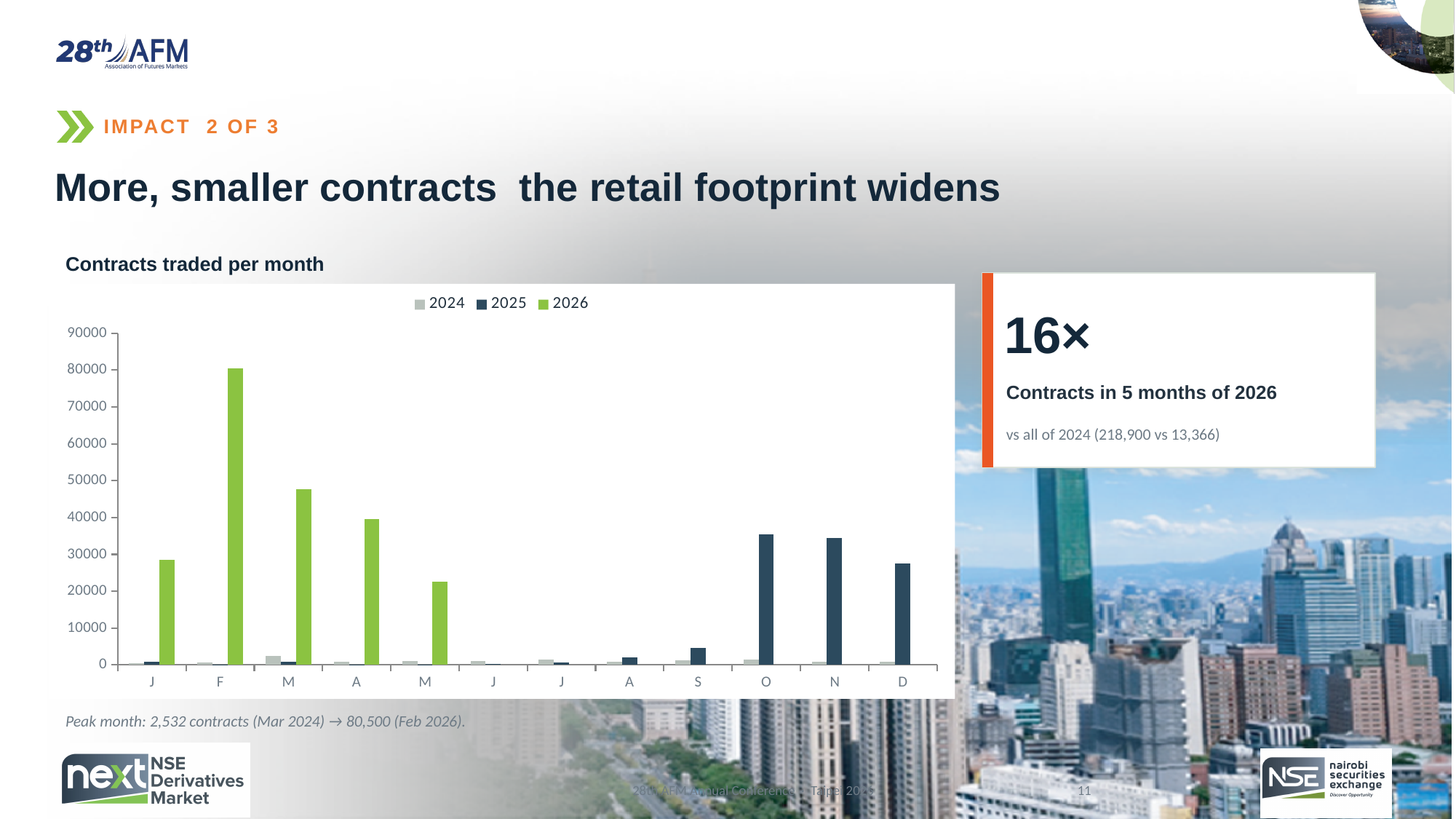
Do the 2026 values rise or fall from F (February) to M (May)? fall Is the 2026 value for M (March) greater or less than 50000? less Which month has the highest 2026 bar in the chart? F Which is larger: the 2026 value for M (March) or the 2026 value for A (April)? M (March) Is the 2025 value for S (September) greater or less than 10000? less What kind of chart is shown on the slide? Bar chart How many series does the legend of the chart list? 3 Is the 2025 value for O (October) greater or less than 30000? greater According to the slide, how many contracts were traded in Mar 2024? 2,532 According to the slide, how many contracts were traded in the peak month, Feb 2026? 80,500 What is the title of the chart? Contracts traded per month How many months are shown along the x axis of the chart? 12